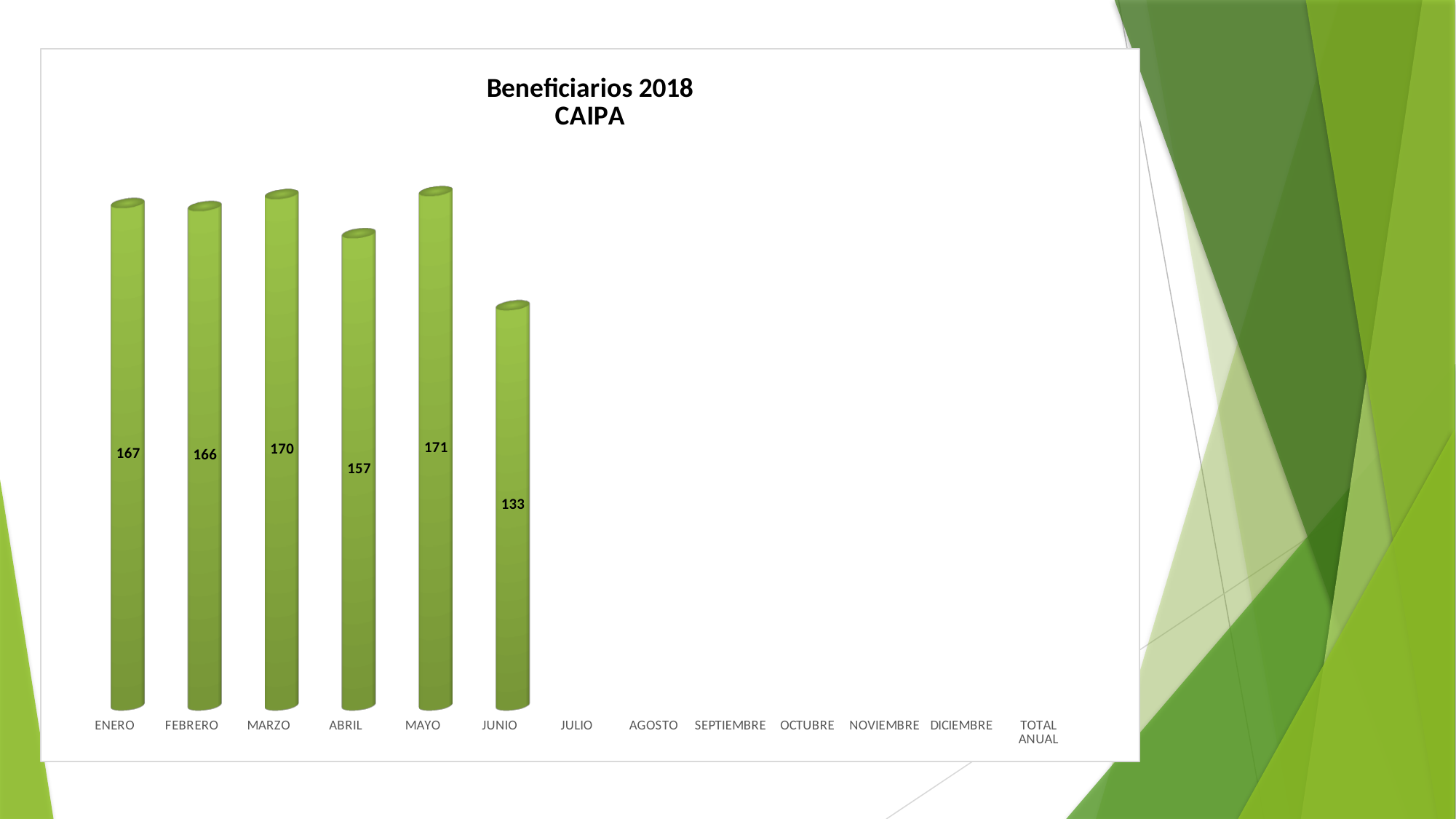
How many months have a bar plotted on the chart? 6 Which month has the highest value? MAYO What is the value for JUNIO? 133 Do the values rise or fall from MAYO to JUNIO? Fall What kind of chart is shown? Bar chart What is the title of the chart? Beneficiarios 2018 CAIPA Which is larger, the value for ENERO or the value for ABRIL? ENERO What is the value for ABRIL? 157 What is the value for ENERO? 167 Which month has the lowest value among those with bars? JUNIO What is the difference between the values for MARZO and ABRIL? 13 What is the difference between the values for MAYO and JUNIO? 38